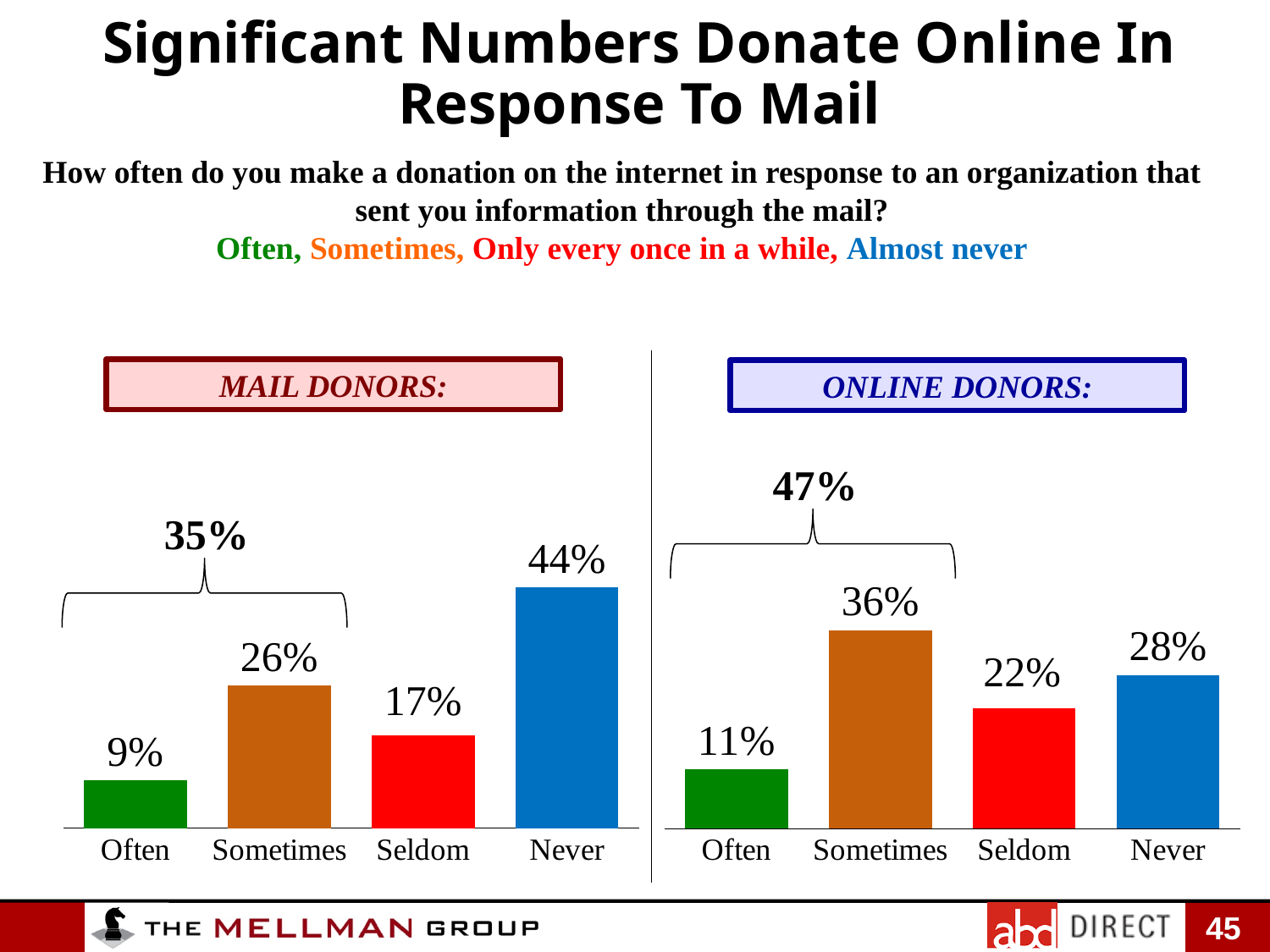
What type of chart is the Mail Donors chart? Bar chart In the Mail Donors chart, which category has the highest value? Never How many categories are shown in the Online Donors chart? 4 In the Online Donors chart, which category has the lowest value? Often Which is larger: Seldom in the Mail Donors chart or Seldom in the Online Donors chart? Online Donors What combined percentage is shown by the bracket over Often and Sometimes in the Online Donors chart? 47% In the Mail Donors chart, what percentage is shown for Never? 44% In the Online Donors chart, what is the difference between Sometimes and Never? 8% In the Mail Donors chart, what is the difference between Never and Sometimes? 18% In the Mail Donors chart, what percentage is shown for Often? 9% In the Online Donors chart, what percentage is shown for Seldom? 22% In the Online Donors chart, what percentage is shown for Sometimes? 36%